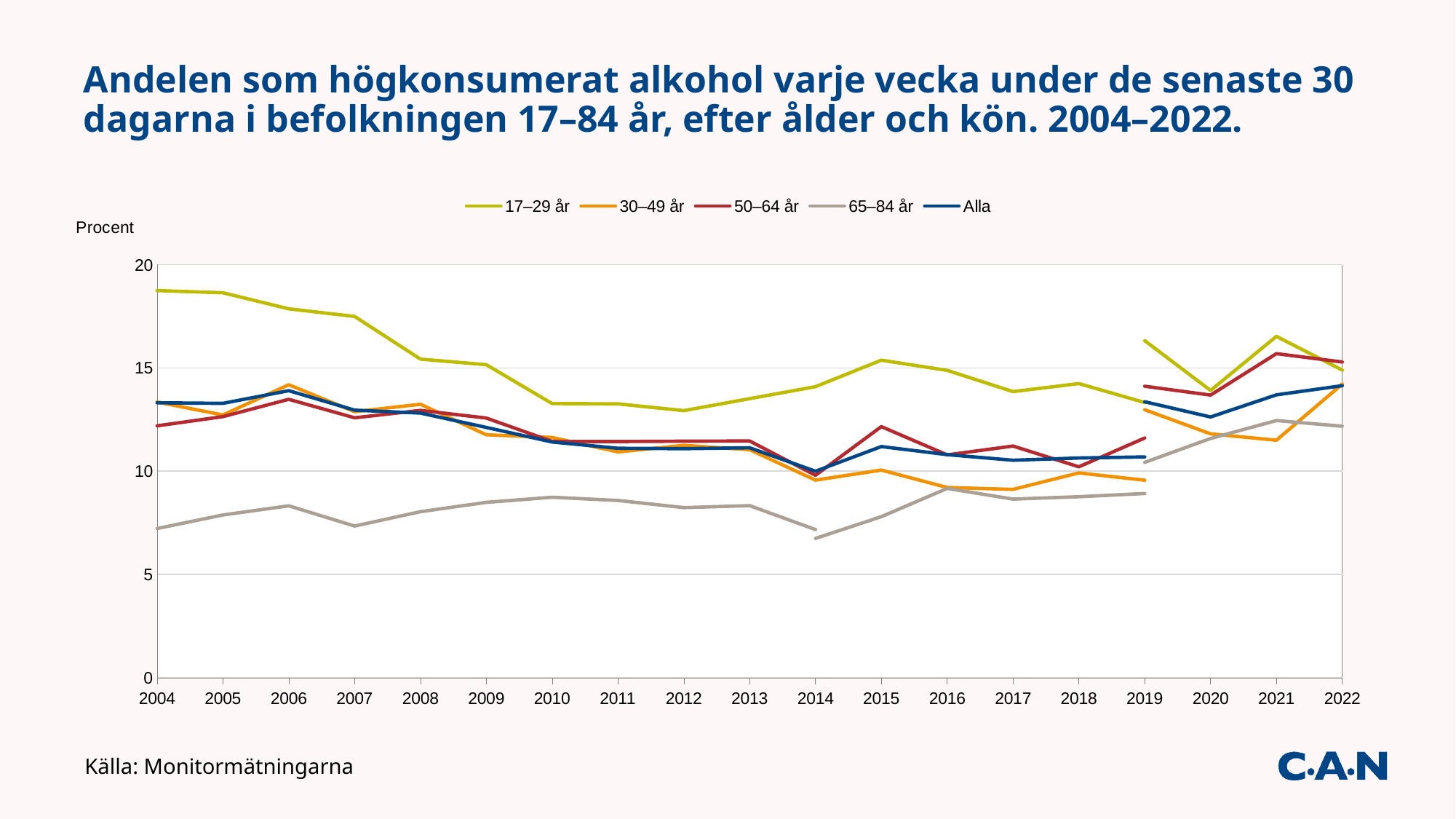
Which series has the lowest value in 2004? 65–84 år How many years are shown along the x axis? 19 Is the value for 30–49 år in 2017 greater or less than 10? less What is the label on the y axis of the chart? Procent Does the 17–29 år series rise or fall from 2004 to 2010? fall Is the value for 17–29 år in 2004 greater or less than 15? greater Which series has the highest value in 2004? 17–29 år In 2022, which is larger: the value for 17–29 år or the value for 65–84 år? 17–29 år How many series does the legend list? 5 What kind of chart is shown on the slide? line chart Is the value for 65–84 år in 2014 greater or less than 10? less Which series has the highest value in 2021? 17–29 år